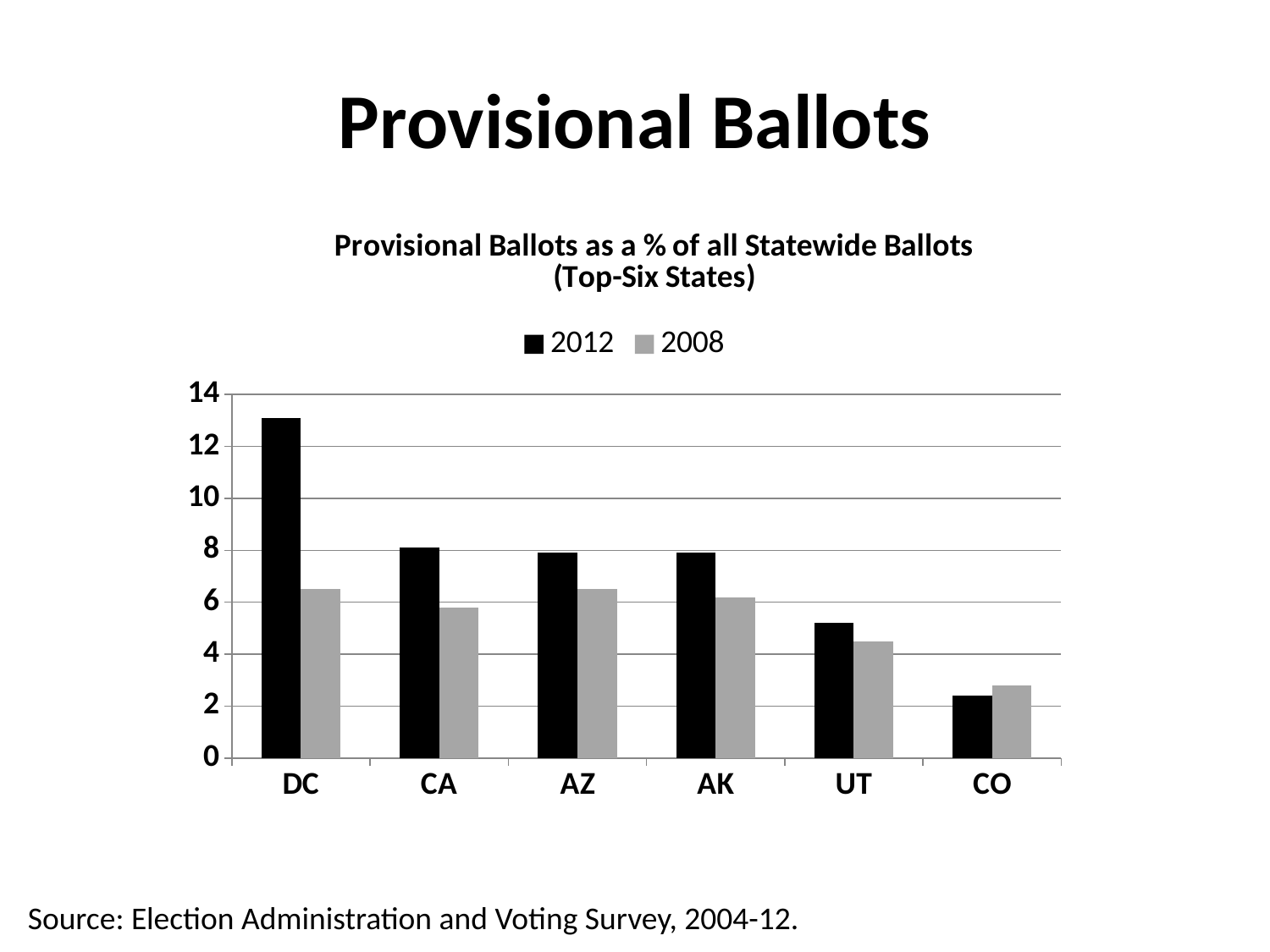
Is the 2012 value for DC greater or less than 12? greater Is the 2012 value for CO greater or less than 4? less What kind of chart is shown on the slide? bar chart How many states are shown on the x axis? 6 Do the 2012 values generally rise or fall from DC to CO along the x axis? fall For DC, which is larger: the 2012 value or the 2008 value? 2012 Which state has the highest 2012 value? DC How many series does the legend list? 2 Which state has the lowest 2008 value? CO For CO, which is larger: the 2012 value or the 2008 value? 2008 Which state has the lowest 2012 value? CO Is the 2008 value for CA greater or less than 6? less